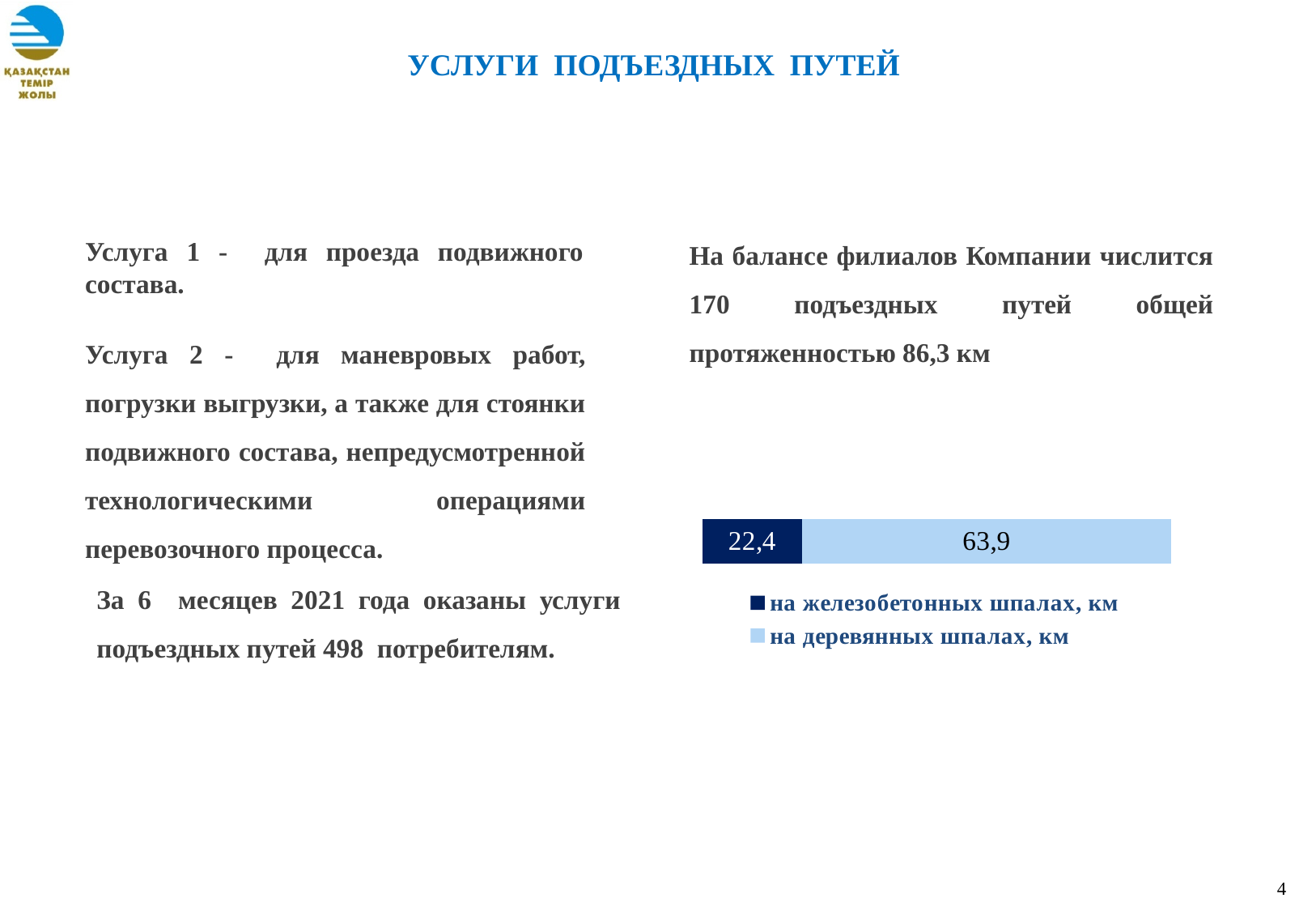
What is the difference between the value for "на деревянных шпалах, км" and the value for "на железобетонных шпалах, км"? 41,5 Which series has the larger value in the chart? на деревянных шпалах, км How many series does the legend of the chart list? 2 What is the value for "на железобетонных шпалах, км" in the chart? 22,4 How many bars are plotted in the chart? 1 What is the total of the stacked bar in the chart? 86,3 What kind of chart is shown on the slide? stacked bar chart Which legend entry is shown in light blue in the chart? на деревянных шпалах, км What is the value for "на деревянных шпалах, км" in the chart? 63,9 Is the value for "на деревянных шпалах, км" larger or smaller than the value for "на железобетонных шпалах, км"? larger Which series has the smaller value in the chart? на железобетонных шпалах, км Which legend entry is shown in dark blue in the chart? на железобетонных шпалах, км